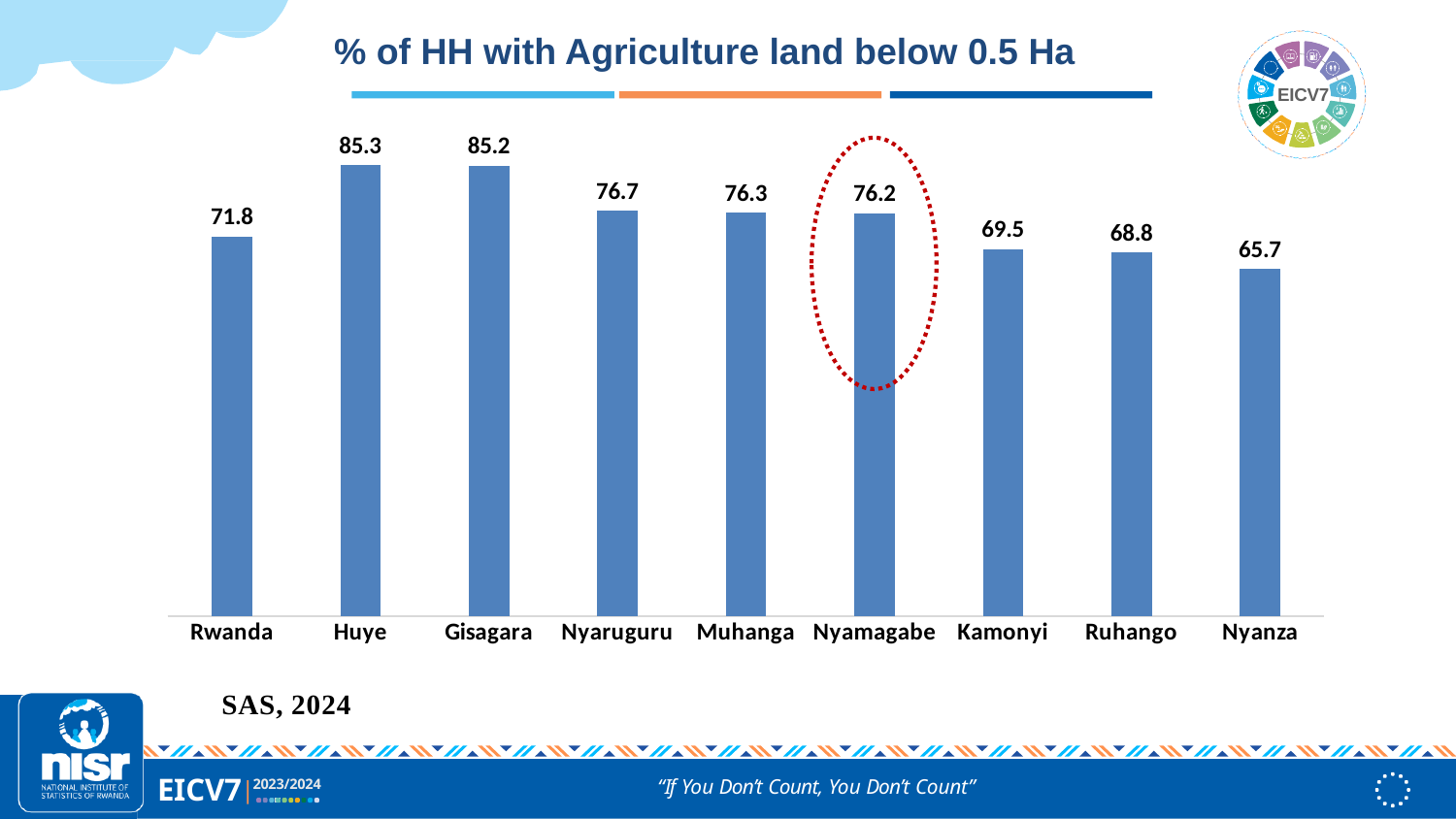
Which is larger, the value for Nyaruguru or the value for Muhanga? Nyaruguru Which category has the lowest value? Nyanza What is the value for Rwanda? 71.8 What is the difference between the values for Huye and Nyanza? 19.6 How many categories are shown on the x axis? 9 What is the value for Nyamagabe? 76.2 What kind of chart is shown on the slide? Bar chart What is the difference between the values for Nyamagabe and Rwanda? 4.4 Which category has the highest value? Huye What is the value for Kamonyi? 69.5 Which category's bar is highlighted with a red dotted circle? Nyamagabe Which is larger, the value for Kamonyi or the value for Ruhango? Kamonyi